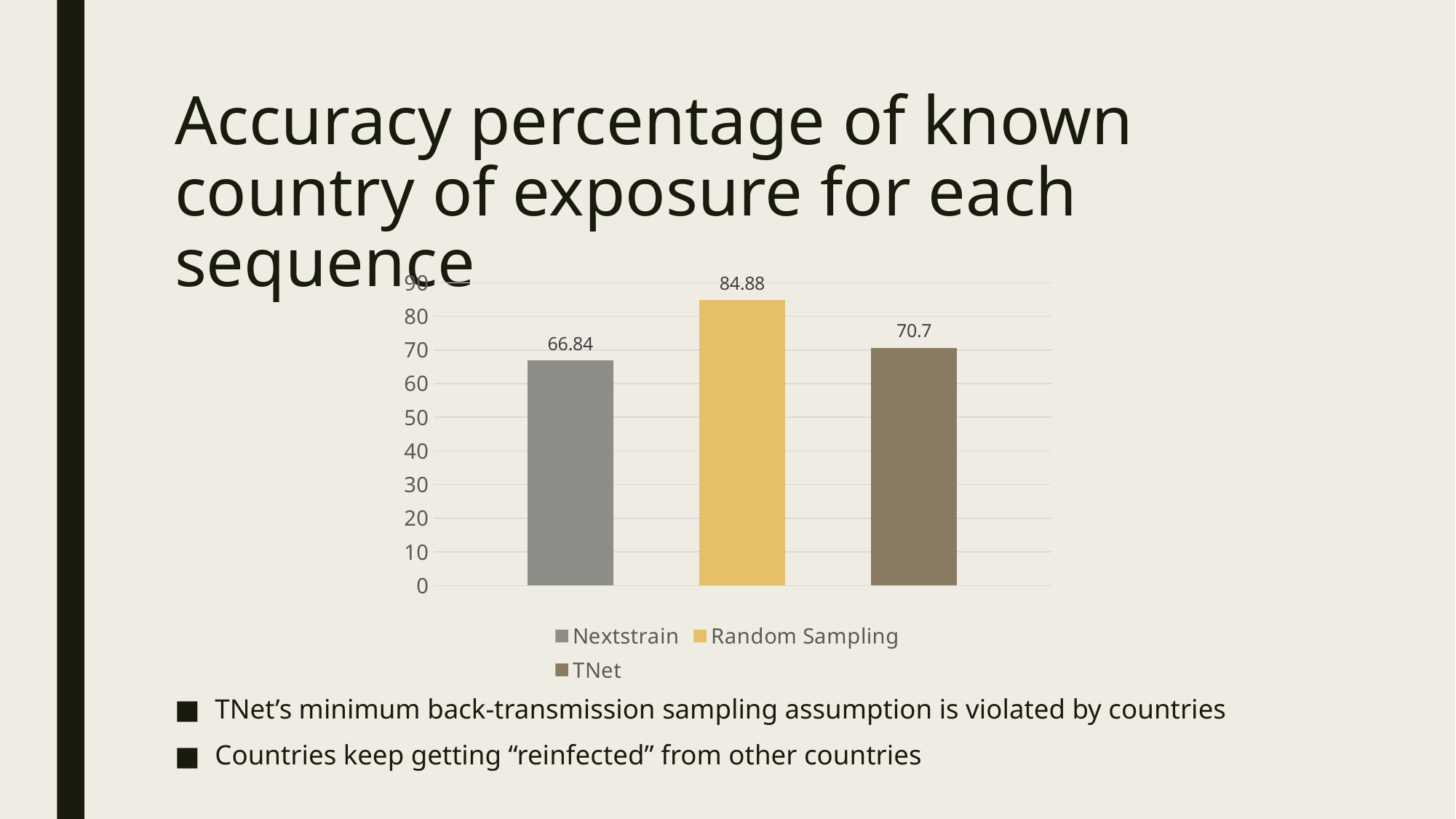
What is the accuracy percentage for TNet? 70.7 What is the accuracy percentage for Nextstrain? 66.84 Which has a higher accuracy percentage, TNet or Nextstrain? TNet What is the accuracy percentage for Random Sampling? 84.88 What is the difference between the accuracy of TNet and Nextstrain? 3.86 Is the value for Random Sampling greater or less than 80? greater Which method has the lowest accuracy percentage? Nextstrain What kind of chart is shown on the slide? Bar chart Which method has the highest accuracy percentage? Random Sampling What colour is the bar for Random Sampling? Yellow What is the difference between the accuracy of Random Sampling and Nextstrain? 18.04 How many series does the legend list? 3